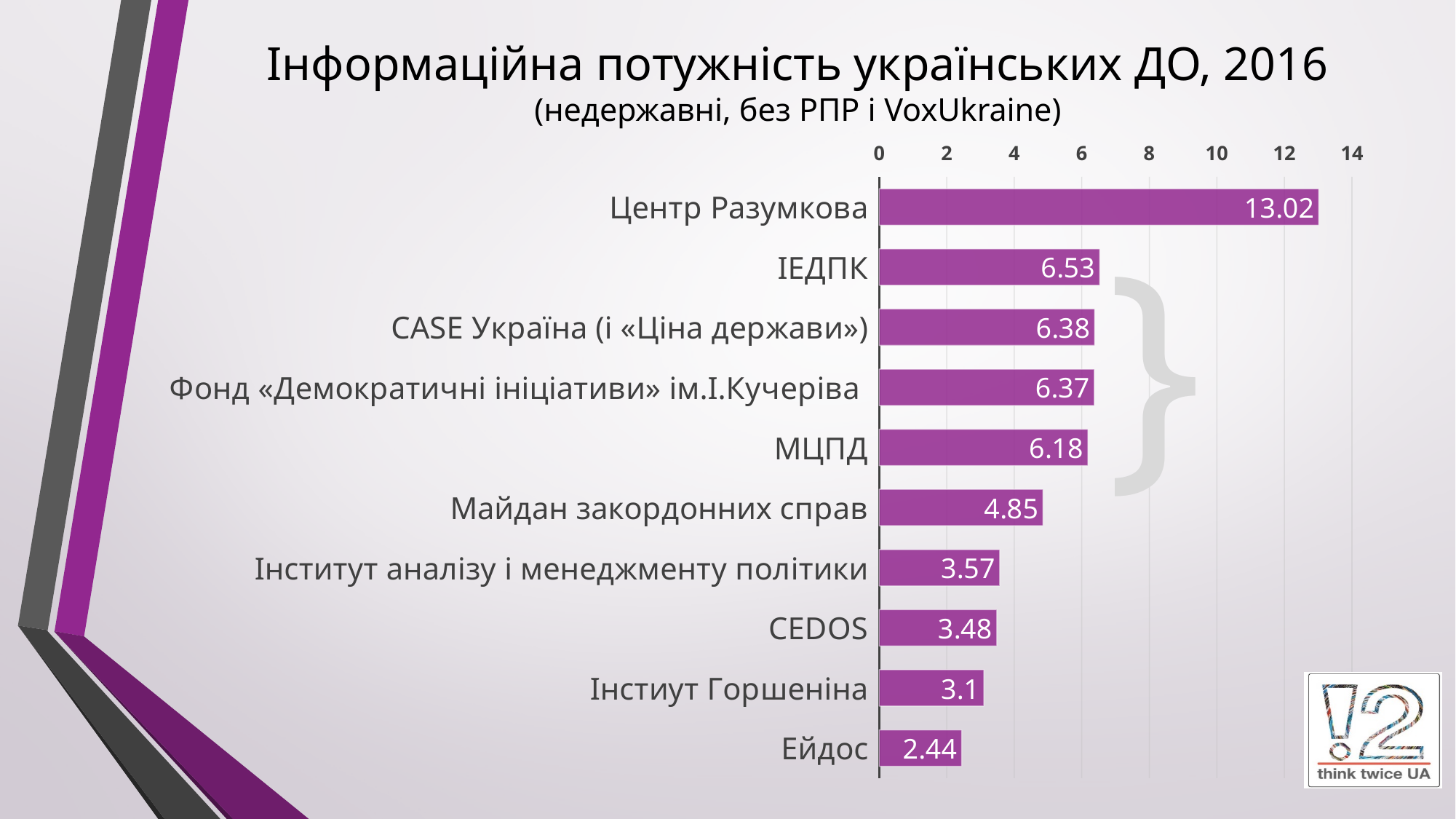
Which organisation has the lowest value? Ейдос Is the value for Інстиут Горшеніна greater or less than 4? less What is the value for Центр Разумкова? 13.02 What is the title of the chart? Інформаційна потужність українських ДО, 2016 How many organisations are shown in the chart? 10 What is the value for CEDOS? 3.48 Which has a larger value, ІЕДПК or CASE Україна (і «Ціна держави»)? ІЕДПК What kind of chart is shown on the slide? bar chart What is the value for Майдан закордонних справ? 4.85 Which organisation has the highest value? Центр Разумкова What is the difference between the values for Центр Разумкова and ІЕДПК? 6.49 What is the difference between the values for Майдан закордонних справ and Ейдос? 2.41